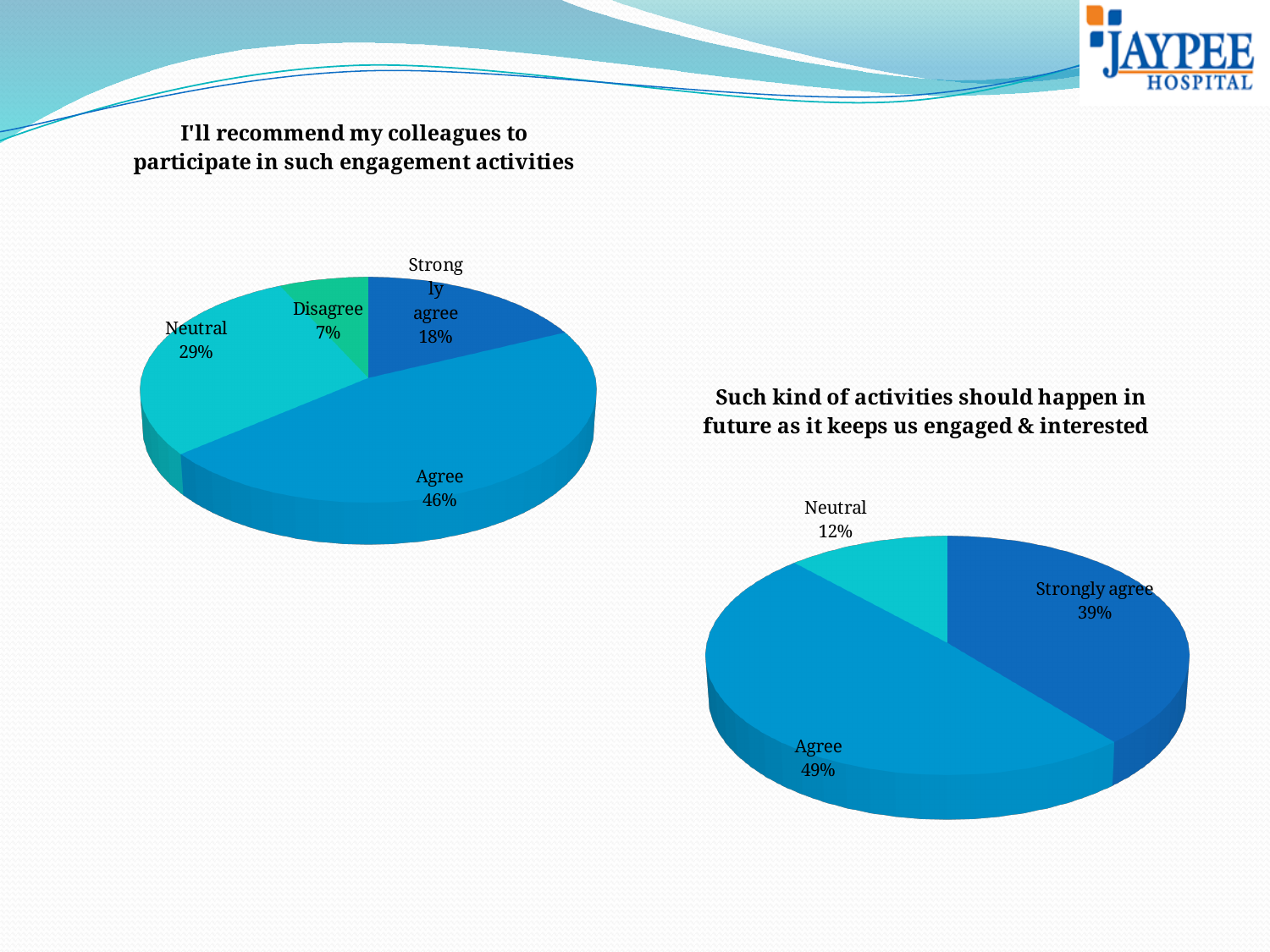
In the chart titled "I'll recommend my colleagues to participate in such engagement activities", how many slices does the pie have? 4 In the chart titled "Such kind of activities should happen in future as it keeps us engaged & interested", which response has the largest share? Agree In the chart titled "Such kind of activities should happen in future as it keeps us engaged & interested", what percentage chose Strongly agree? 39% In the chart titled "I'll recommend my colleagues to participate in such engagement activities", what is the difference between the Neutral and Strongly agree shares? 11% In the chart titled "Such kind of activities should happen in future as it keeps us engaged & interested", what percentage chose Neutral? 12% What type of chart is used for both charts on the slide? Pie chart In the chart titled "I'll recommend my colleagues to participate in such engagement activities", what percentage of respondents chose Agree? 46% In the chart titled "Such kind of activities should happen in future as it keeps us engaged & interested", how many slices does the pie have? 3 In the chart titled "I'll recommend my colleagues to participate in such engagement activities", what percentage chose Disagree? 7% In the chart titled "I'll recommend my colleagues to participate in such engagement activities", which response has the smallest share? Disagree In the chart titled "Such kind of activities should happen in future as it keeps us engaged & interested", which is larger, Agree or Strongly agree? Agree In the chart titled "I'll recommend my colleagues to participate in such engagement activities", which response has the largest share? Agree